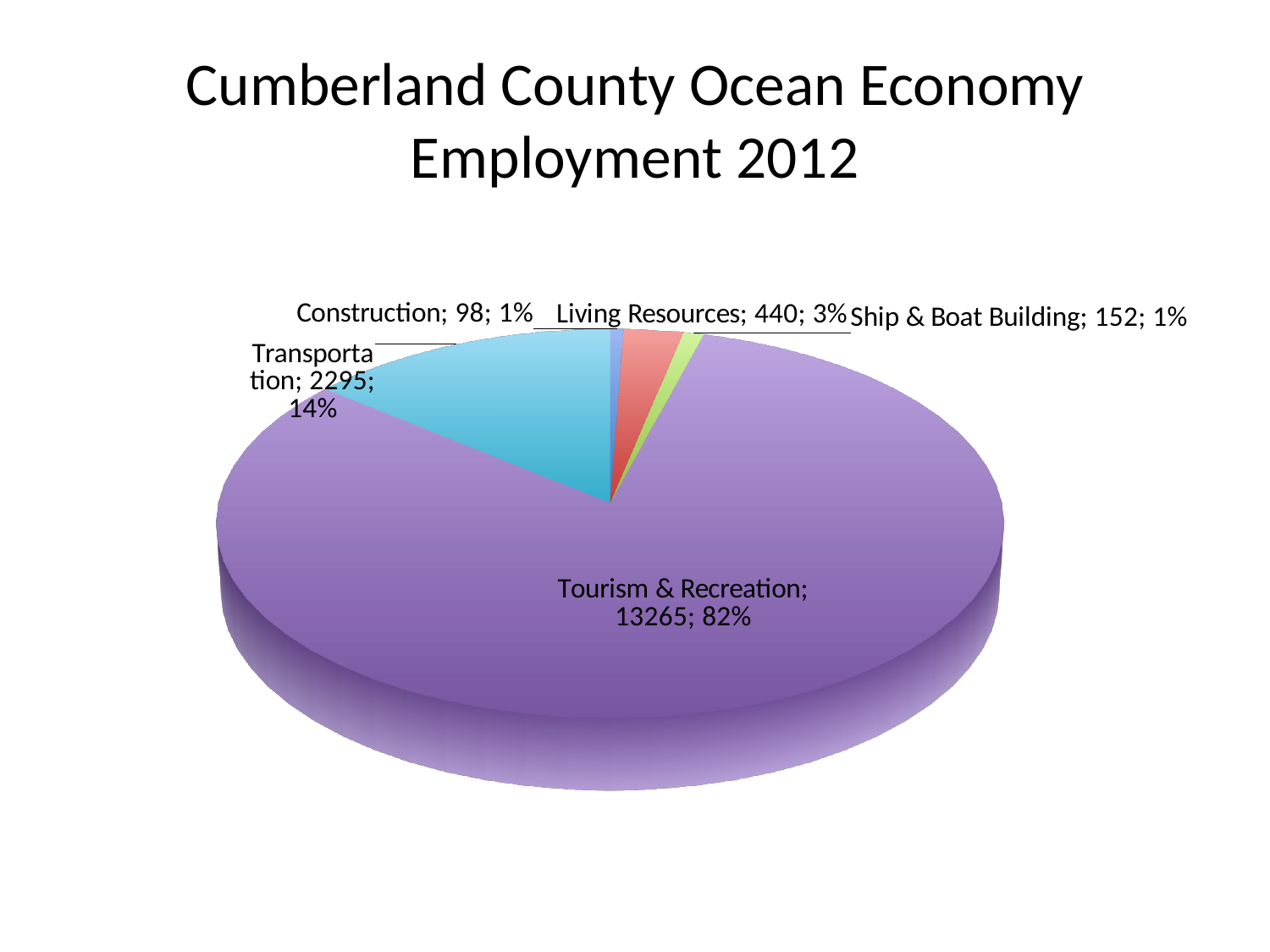
What is the employment value for Living Resources? 440 What share of the pie does Transportation represent? 14% Which category has the lowest employment? Construction What kind of chart is shown on the slide? Pie chart What is the difference in employment between Transportation and Living Resources? 1855 What is the employment value for Ship & Boat Building? 152 What is the employment value for Transportation? 2295 How many categories are shown in the pie chart? 5 What is the employment value for Tourism & Recreation? 13265 What share of the pie does Living Resources represent? 3% Which category has the highest employment? Tourism & Recreation Which is larger, the employment for Ship & Boat Building or for Construction? Ship & Boat Building